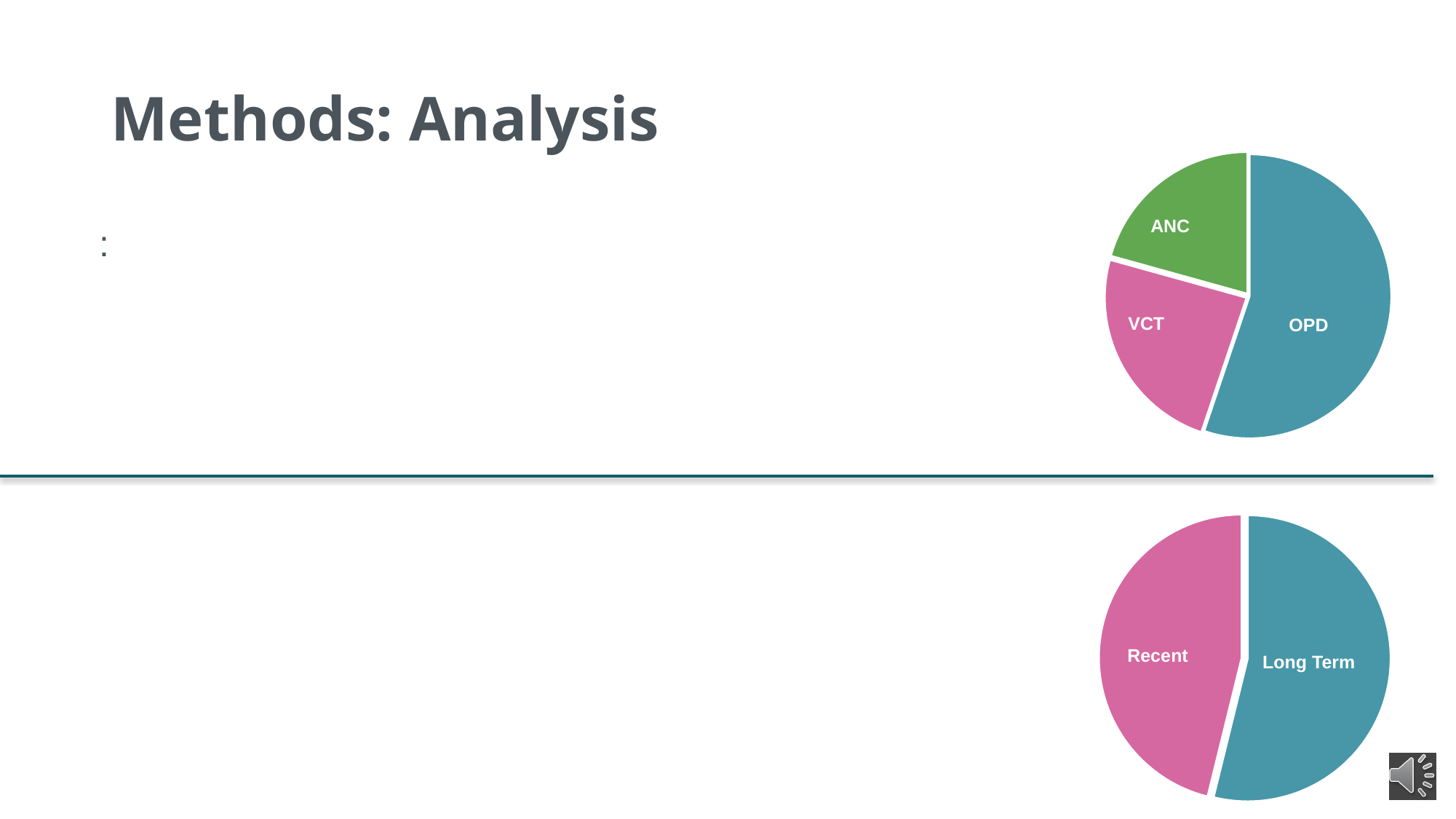
How many slices does the top pie chart have? 3 In the top pie chart, which slice is larger, OPD or VCT? OPD What kind of chart is the top chart on the slide? pie chart How many slices does the bottom pie chart have? 2 In the top pie chart, which slice is the largest? OPD In the top pie chart, which slice is the smallest? ANC In the bottom pie chart, what are the labels of the two slices? Recent and Long Term In the top pie chart, which slice is larger, OPD or ANC? OPD What kind of chart is the bottom chart on the slide? pie chart In the top pie chart, what colour is the ANC slice? green